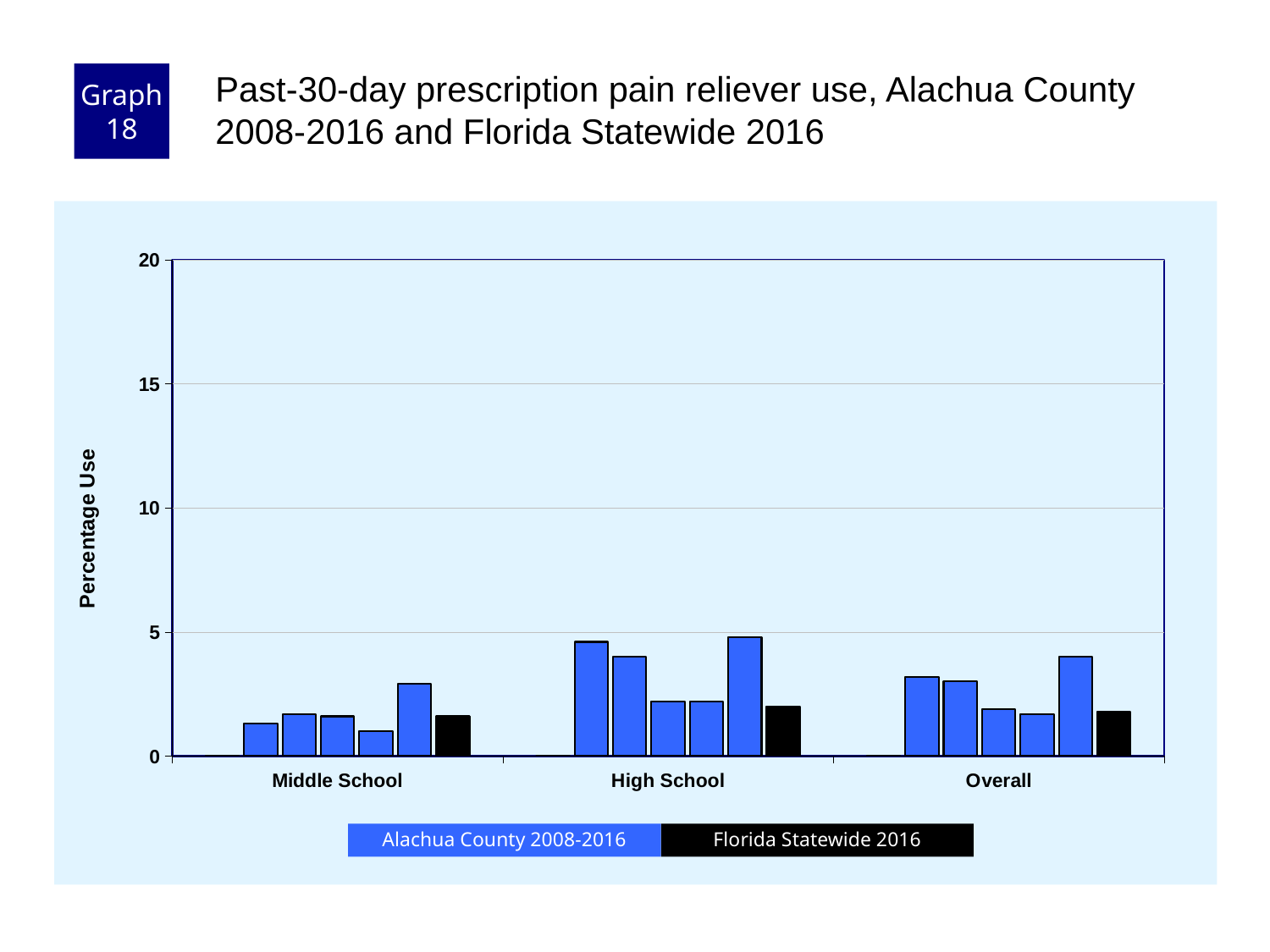
What is the highest value shown on the y axis? 20 Are any of the bars on the chart greater than 10? No What is the label of the y axis? Percentage Use Is the value for Florida Statewide 2016 in the Middle School category greater or less than 5? less For Florida Statewide 2016, which is larger: the High School value or the Middle School value? High School How many categories are shown along the x axis? 3 Which category contains the tallest bar on the chart? High School What kind of chart is shown on the slide? bar chart How many series does the legend list? 2 Which colour represents Florida Statewide 2016 in the legend? black Is the value for Florida Statewide 2016 in the High School category greater or less than 5? less